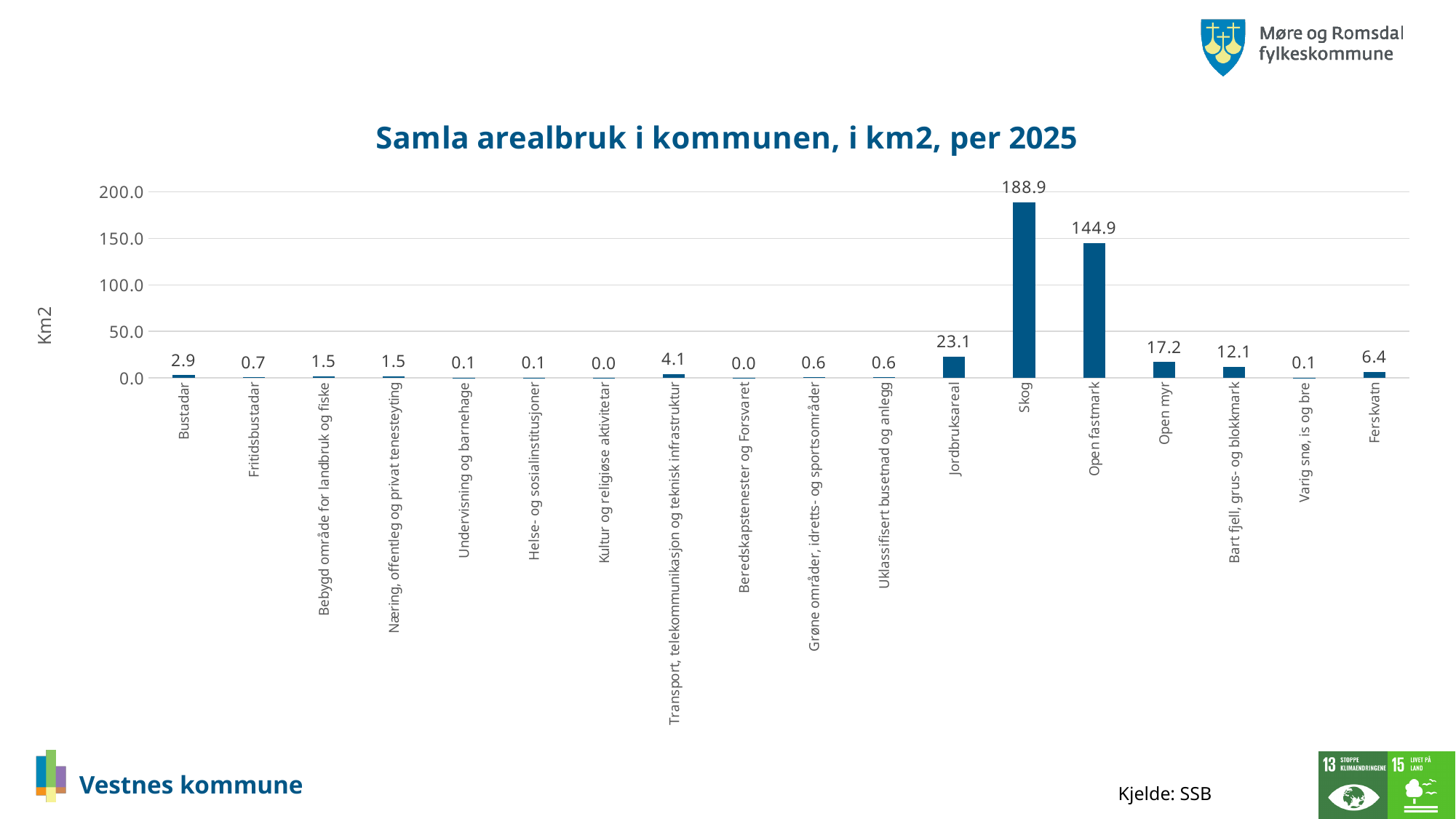
Is the value for Open fastmark greater or less than 100.0? greater What is the difference between the values for Jordbruksareal and Open myr? 5.9 What is the title of the chart? Samla arealbruk i kommunen, i km2, per 2025 What is the difference between the values for Skog and Open fastmark? 44.0 What is the value for Open fastmark? 144.9 What is the value for Jordbruksareal? 23.1 What is the value for Ferskvatn? 6.4 What is the value for Skog? 188.9 Which is larger, the value for Open myr or the value for Bart fjell, grus- og blokkmark? Open myr Which category has the highest value? Skog What is the value for Bart fjell, grus- og blokkmark? 12.1 How many categories are shown on the x axis? 18